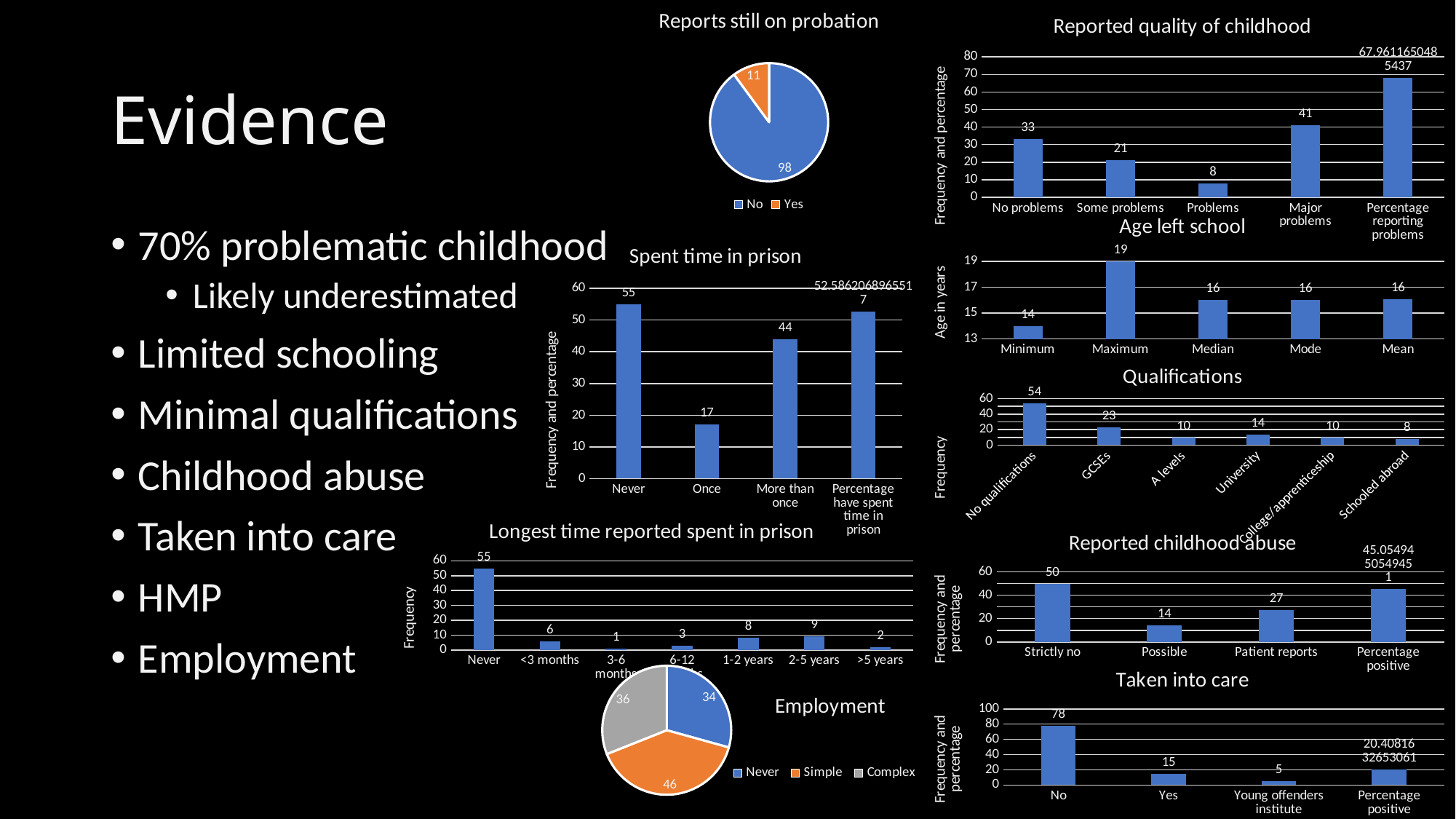
In the 'Reports still on probation' pie chart, what is the value for 'No'? 98 In the 'Reported quality of childhood' chart, what is the value for 'Major problems'? 41 In the 'Age left school' chart, what is the value for 'Maximum'? 19 In the 'Qualifications' chart, which category has the highest value? No qualifications In the 'Longest time reported spent in prison' chart, what is the value for '2-5 years'? 9 In the 'Spent time in prison' chart, what is the difference between the values for 'Never' and 'Once'? 38 In the 'Qualifications' chart, how many categories are shown on the x axis? 6 What kind of chart is 'Employment'? Pie chart In the 'Employment' pie chart, what is the value for 'Simple'? 46 In the 'Reported childhood abuse' chart, which is larger, 'Possible' or 'Patient reports'? Patient reports In the 'Taken into care' chart, what is the value for 'Yes'? 15 In the 'Reported quality of childhood' chart, which of the four frequency categories (excluding the percentage bar) has the lowest value? Problems